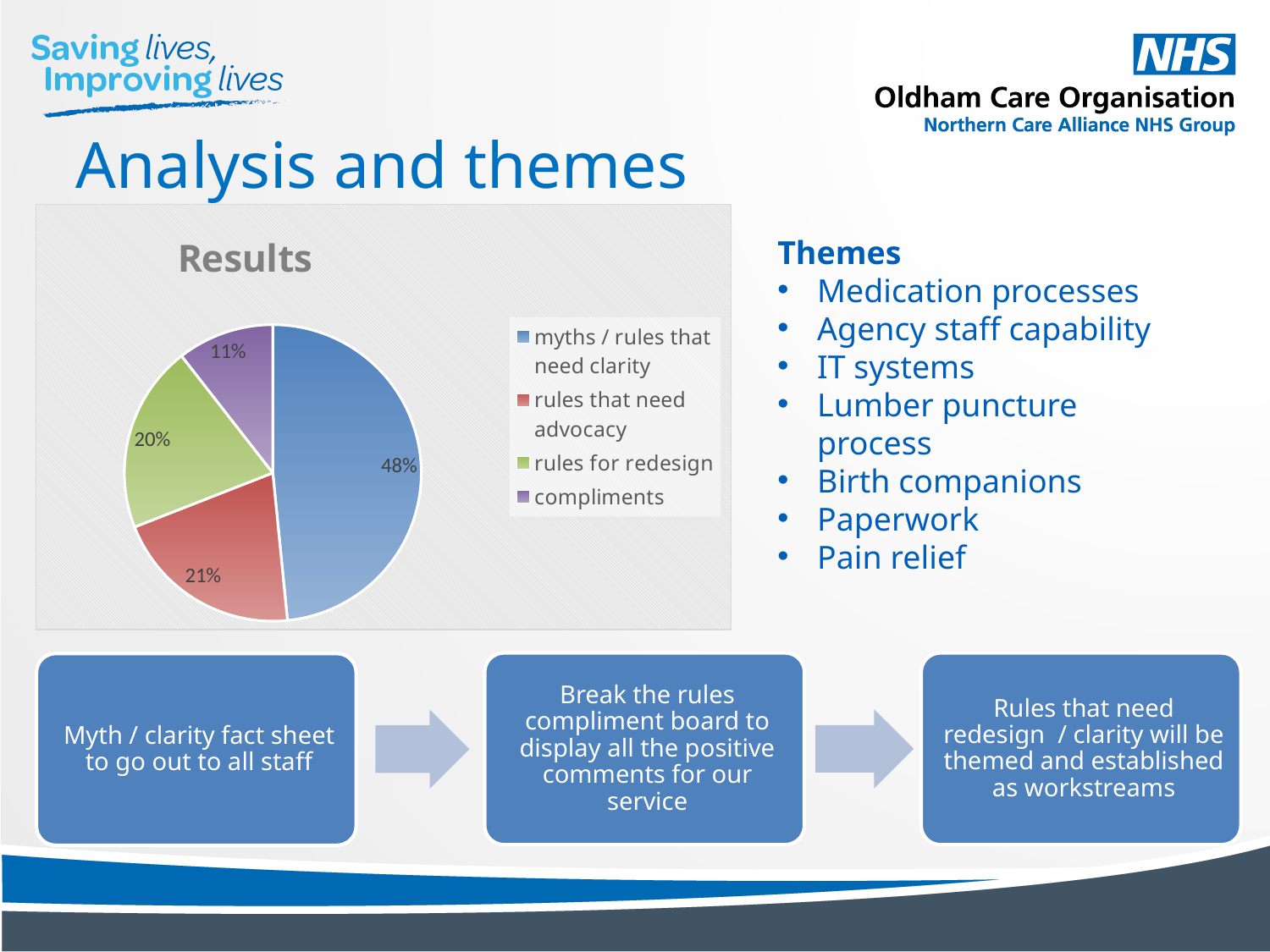
What share of the pie is labelled "myths / rules that need clarity"? 48% Which category has the smallest slice of the pie? compliments What percentage is shown for "compliments"? 11% Which colour represents "rules that need advocacy" in the legend? red What percentage is shown for "rules for redesign"? 20% Which is larger: the slice for "rules for redesign" or the slice for "compliments"? rules for redesign What percentage is shown for "rules that need advocacy"? 21% Which category has the largest slice of the pie? myths / rules that need clarity What is the title of the chart? Results What type of chart is shown under the title "Results"? pie chart What is the difference in percentage points between "myths / rules that need clarity" and "compliments"? 37 How many categories does the pie chart show? 4